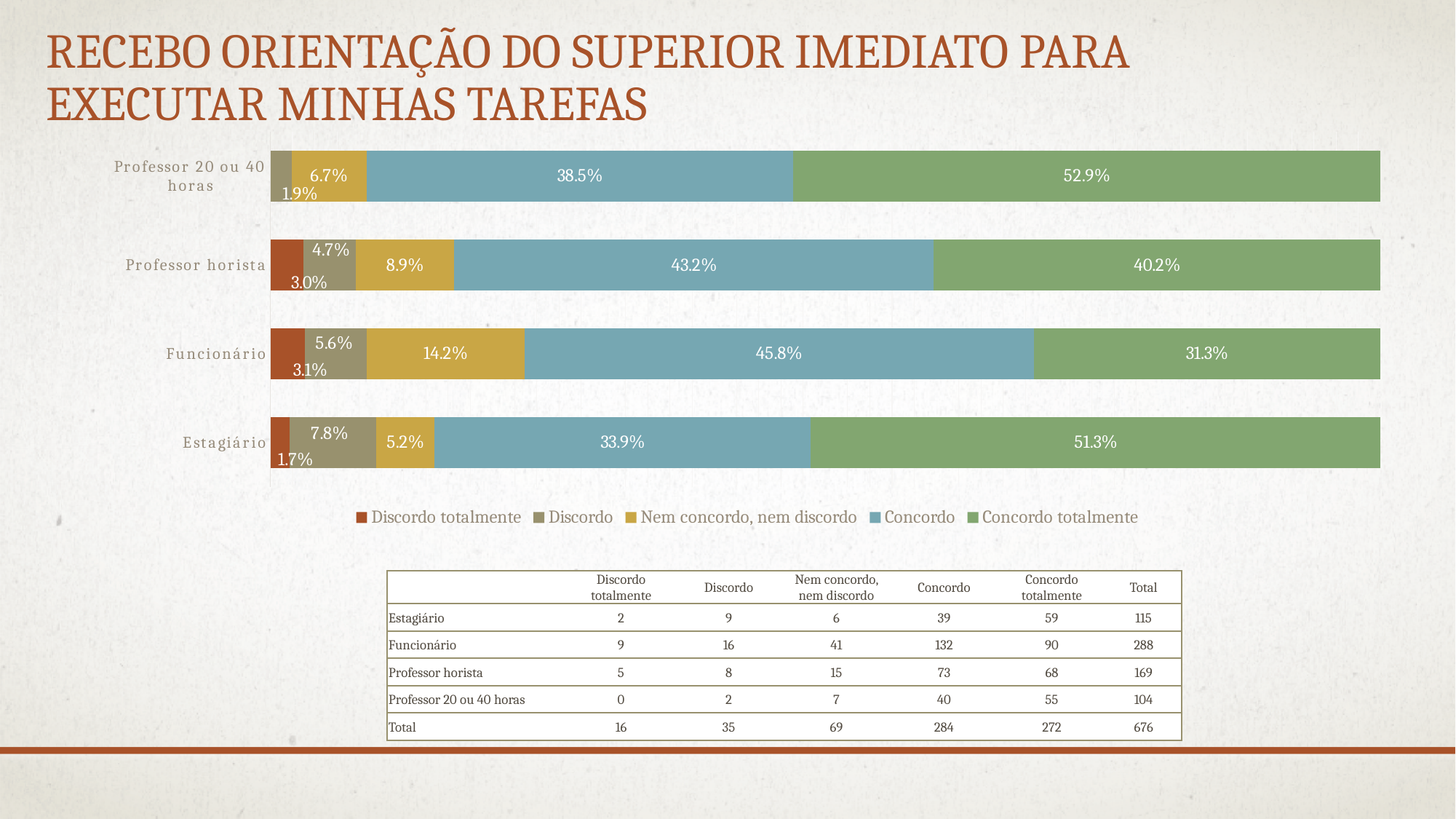
What is the "Nem concordo, nem discordo" value for Professor horista? 8.9% What kind of chart is shown on the slide? Stacked bar chart What is the "Concordo totalmente" value for Professor 20 ou 40 horas? 52.9% What is the difference between the "Concordo totalmente" values for Estagiário and Funcionário? 20.0% Which is larger for Professor horista: "Concordo" or "Concordo totalmente"? Concordo What percentage of Funcionário respondents answered "Concordo"? 45.8% What is the "Discordo" value for Estagiário? 7.8% Which category has the lowest "Concordo" percentage? Estagiário Which legend entry is shown in green? Concordo totalmente Which category has the highest "Concordo totalmente" percentage? Professor 20 ou 40 horas How many series does the legend list? 5 How many categories are shown on the chart? 4